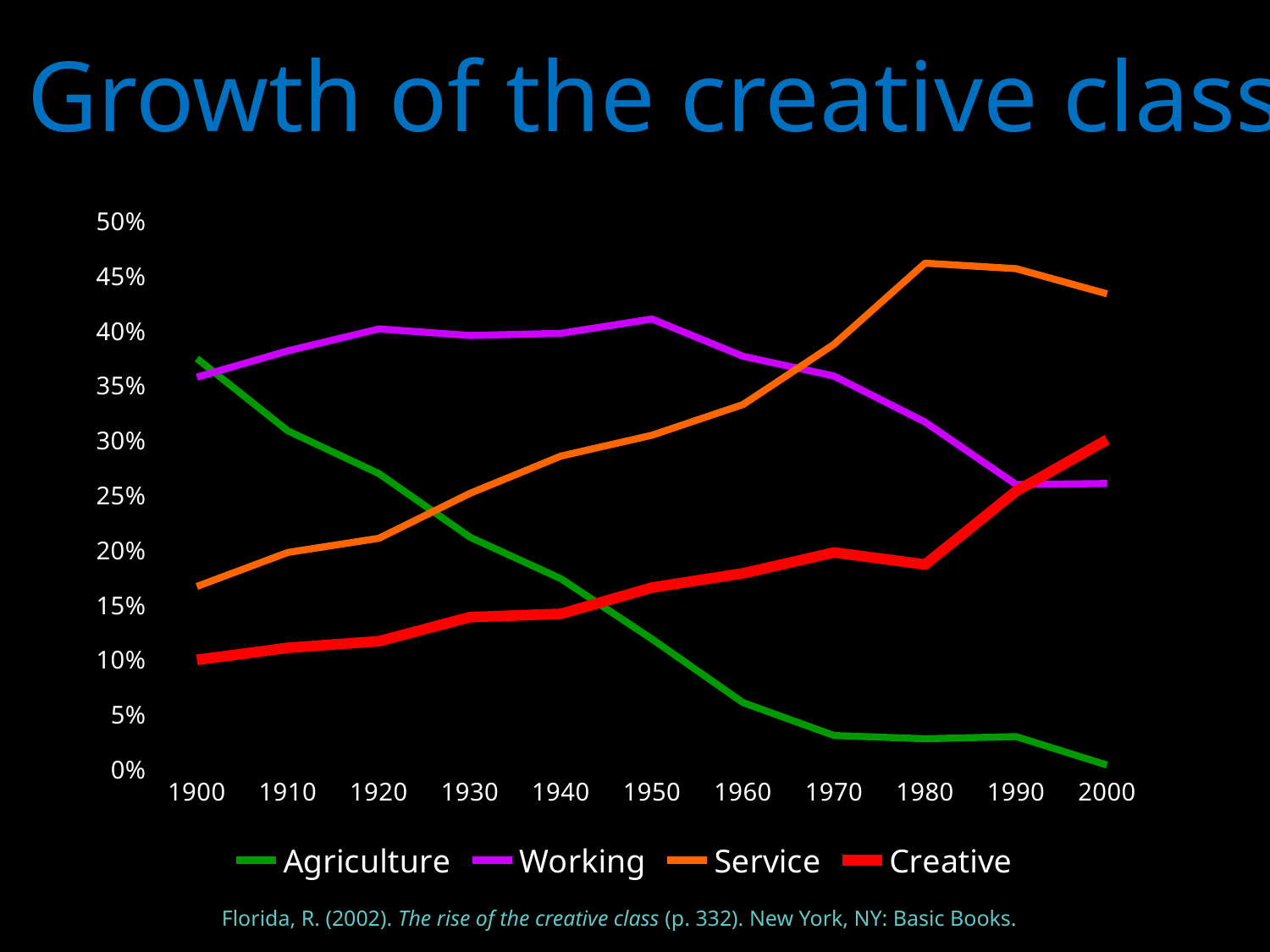
Does the Service line rise or fall from 1900 to 1980? rise Which series has the highest value in 1950? Working Is the value for Service in 1980 greater or less than 40%? greater Is the value for Working in 1920 greater or less than 35%? greater How many years are marked along the x axis? 11 Does the Agriculture line rise or fall from 1900 to 2000? fall In 2000, which is larger, the Service value or the Working value? Service How many series does the legend list? 4 What kind of chart is shown on the slide? line chart Which series has the lowest value in 2000? Agriculture Is the value for Creative in 2000 greater or less than 25%? greater